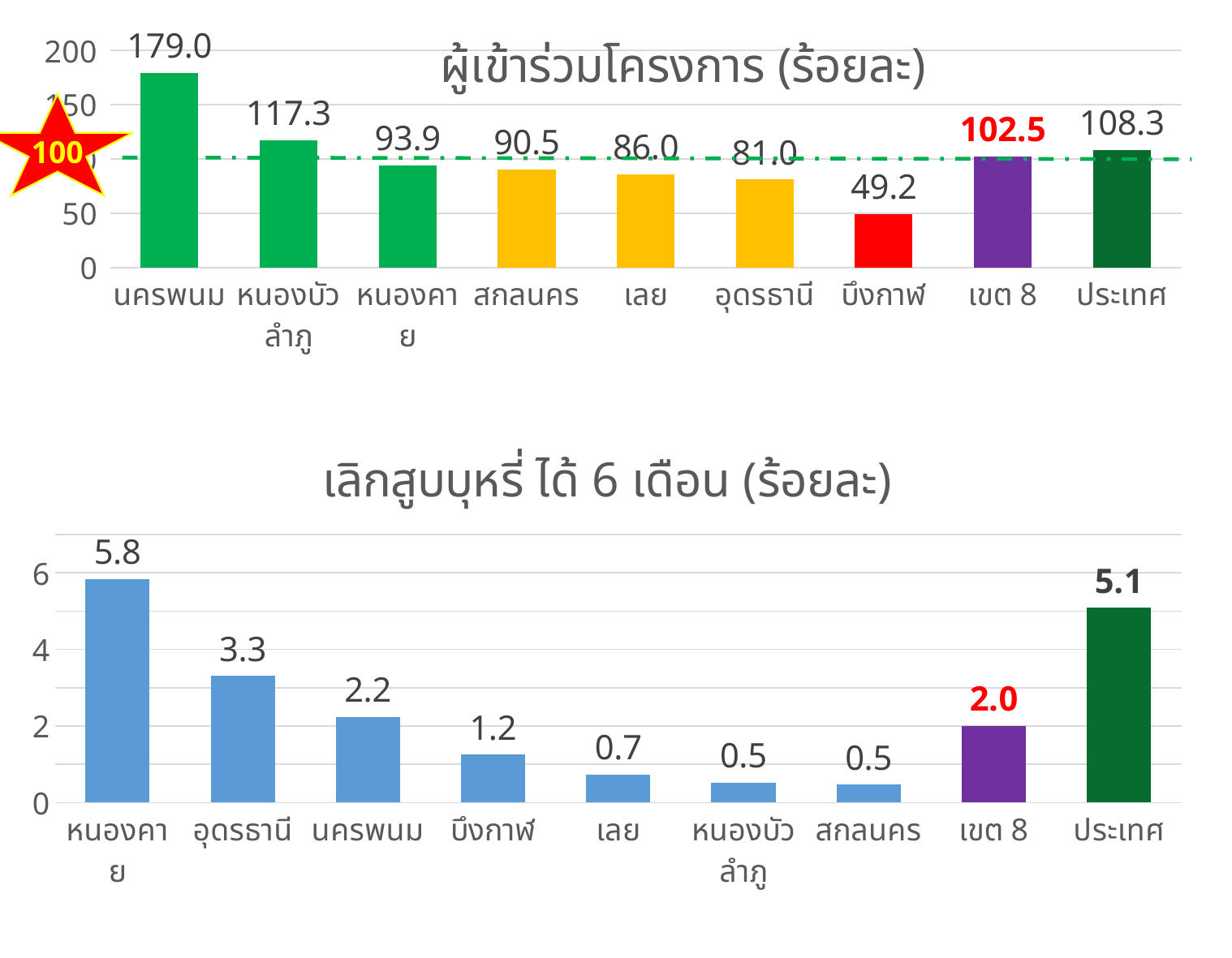
In the bottom chart (เลิกสูบบุหรี่ ได้ 6 เดือน (ร้อยละ)), what is the difference between the values for อุดรธานี and นครพนม? 1.1 In the top chart (ผู้เข้าร่วมโครงการ (ร้อยละ)), what is the value for เขต 8? 102.5 In the top chart (ผู้เข้าร่วมโครงการ (ร้อยละ)), what is the value for นครพนม? 179.0 In the bottom chart (เลิกสูบบุหรี่ ได้ 6 เดือน (ร้อยละ)), what is the value for หนองคาย? 5.8 In the bottom chart (เลิกสูบบุหรี่ ได้ 6 เดือน (ร้อยละ)), which category has the highest value? หนองคาย In the top chart (ผู้เข้าร่วมโครงการ (ร้อยละ)), how many categories are shown? 9 In the top chart (ผู้เข้าร่วมโครงการ (ร้อยละ)), what is the difference between the values for ประเทศ and เขต 8? 5.8 In the top chart (ผู้เข้าร่วมโครงการ (ร้อยละ)), which is larger, the value for สกลนคร or the value for อุดรธานี? สกลนคร In the bottom chart (เลิกสูบบุหรี่ ได้ 6 เดือน (ร้อยละ)), is the value for เขต 8 greater or less than 4? less In the bottom chart (เลิกสูบบุหรี่ ได้ 6 เดือน (ร้อยละ)), what is the value for ประเทศ? 5.1 What kind of chart is the bottom chart (เลิกสูบบุหรี่ ได้ 6 เดือน (ร้อยละ))? bar chart In the top chart (ผู้เข้าร่วมโครงการ (ร้อยละ)), which category has the lowest value? บึงกาฬ